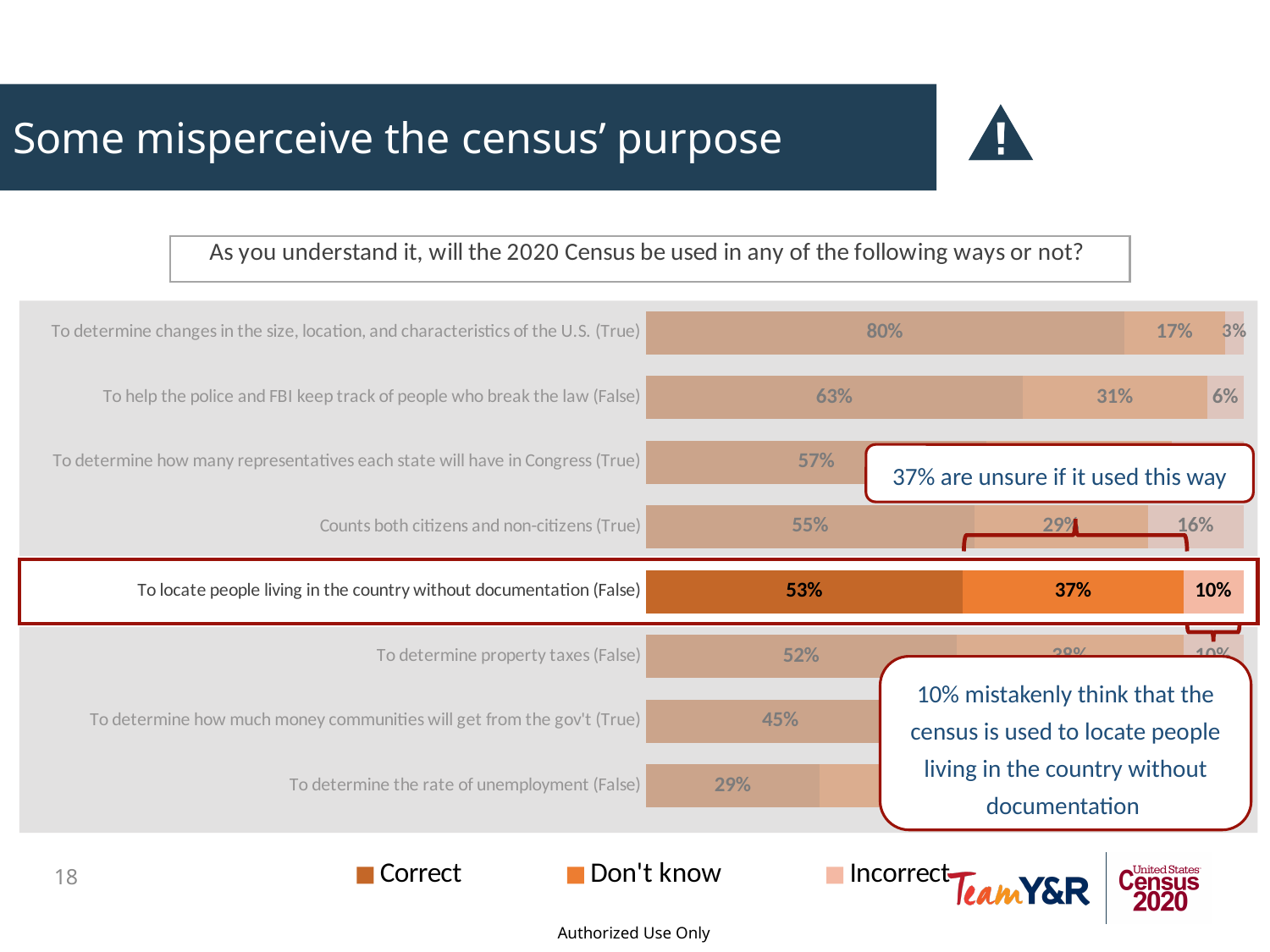
Which category has the lowest Correct value? To determine the rate of unemployment (False) How many series does the legend list? 3 How many categories (census uses) are plotted in the chart? 8 What is the Correct value for 'To determine changes in the size, location, and characteristics of the U.S. (True)'? 80% Which category has the highest Correct value? To determine changes in the size, location, and characteristics of the U.S. (True) Which has a larger Don't know value: 'To locate people living in the country without documentation (False)' or 'Counts both citizens and non-citizens (True)'? To locate people living in the country without documentation (False) What is the Incorrect value for 'To locate people living in the country without documentation (False)'? 10% What kind of chart is shown on the slide? Stacked bar chart What is the Incorrect value for 'Counts both citizens and non-citizens (True)'? 16% What is the difference between the Correct values for 'To help the police and FBI keep track of people who break the law (False)' and 'To locate people living in the country without documentation (False)'? 10% What is the Don't know value for 'To help the police and FBI keep track of people who break the law (False)'? 31% Which series is shown in the darkest orange colour in the legend? Correct